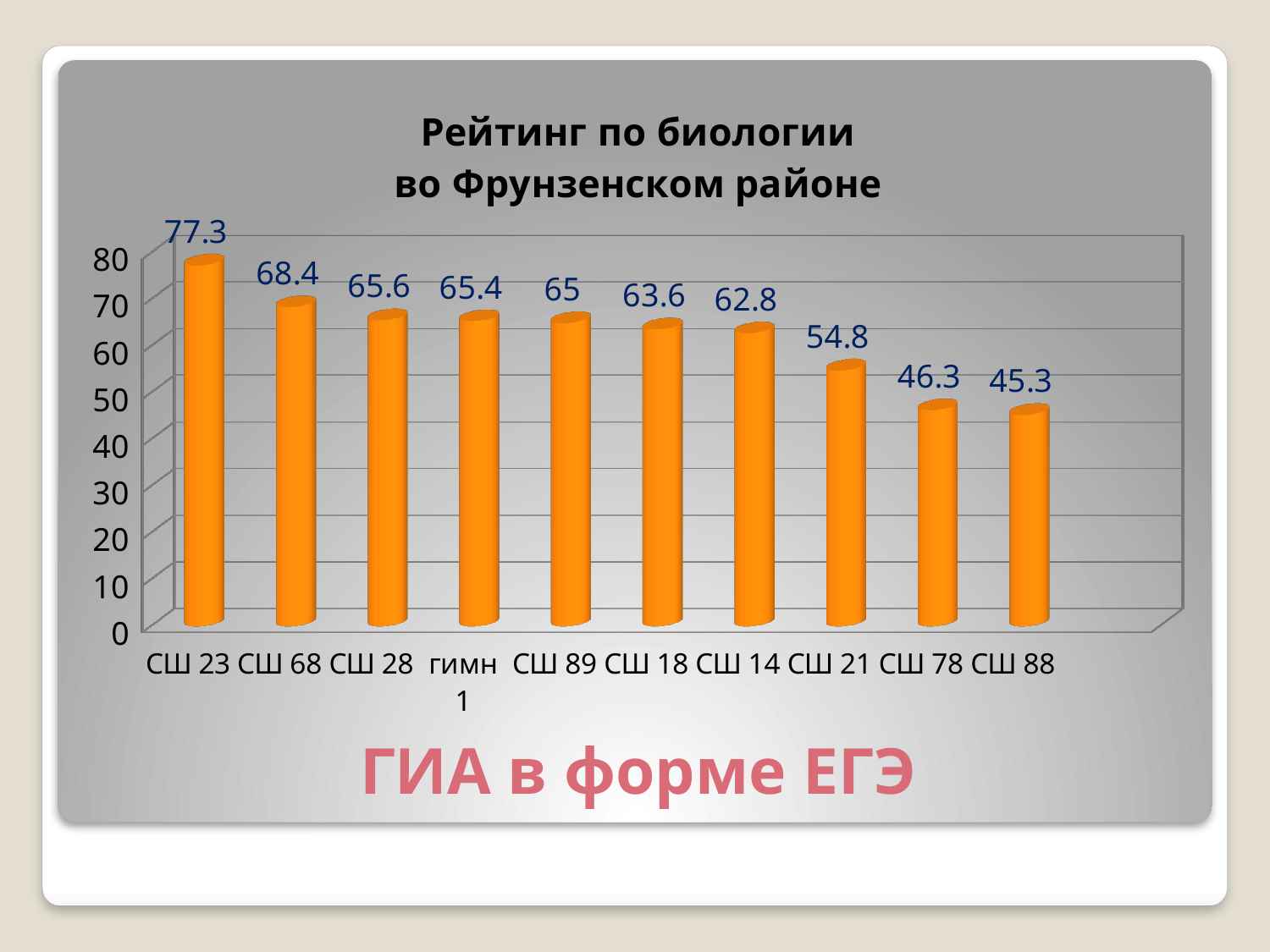
Which is larger, the value for СШ 14 or the value for СШ 21? СШ 14 What is the value for СШ 21? 54.8 Do the values rise or fall from left to right along the x axis? fall What kind of chart is shown? bar chart What is the value for гимн 1? 65.4 What is the difference between the values for СШ 78 and СШ 88? 1 Is the value for СШ 89 greater or less than 60? greater Which school has the lowest value? СШ 88 What is the difference between the values for СШ 23 and СШ 68? 8.9 How many schools are shown on the chart? 10 Which school has the highest value? СШ 23 What is the value for СШ 23? 77.3